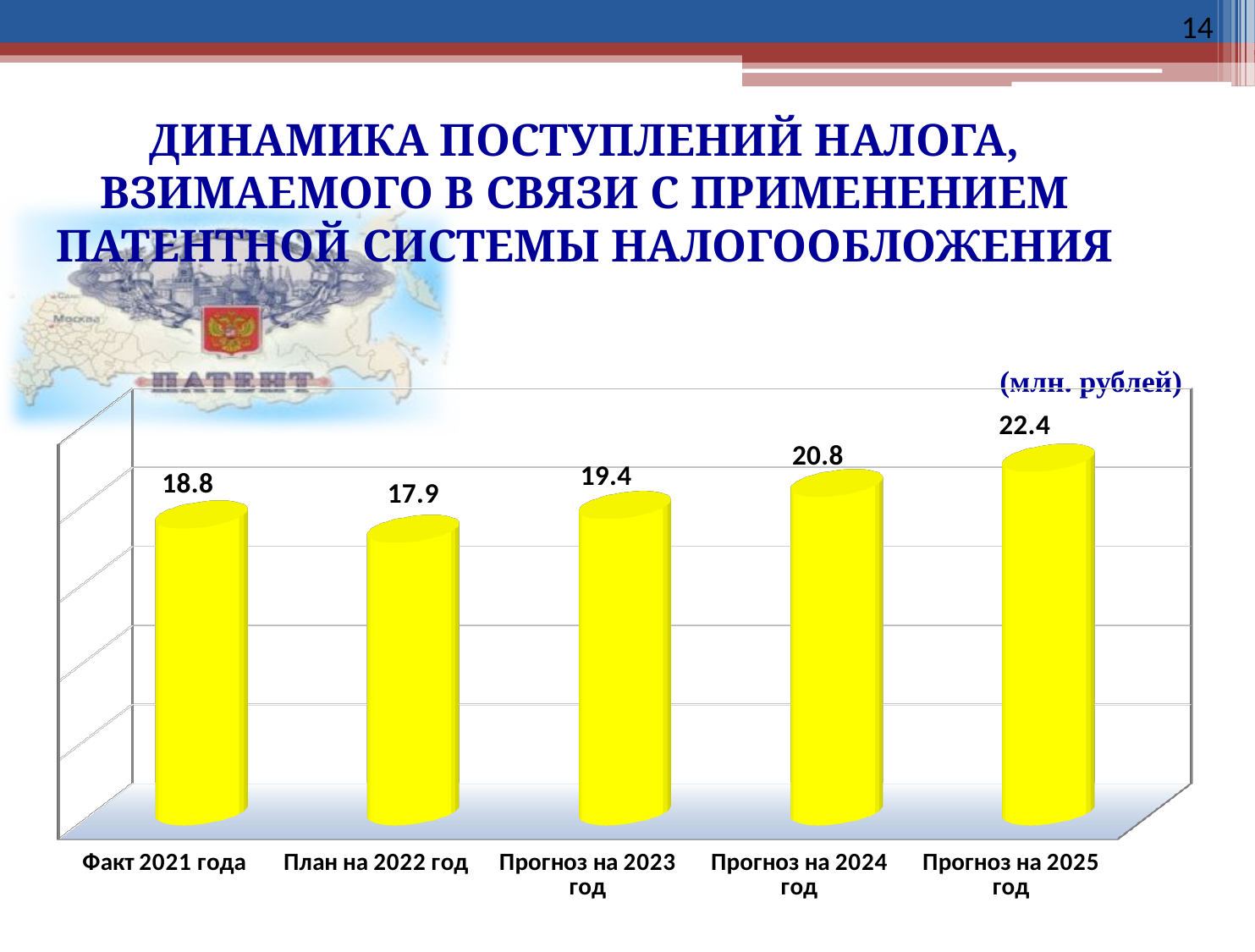
What is the value for План на 2022 год? 17.9 Do the values rise or fall from Прогноз на 2023 год to Прогноз на 2025 год? Rise Which is larger, the value for Факт 2021 года or the value for Прогноз на 2023 год? Прогноз на 2023 год How many categories are shown on the chart? 5 What kind of chart is shown on the slide? Bar chart What is the value for Прогноз на 2024 год? 20.8 What is the value for Факт 2021 года? 18.8 What is the difference between the values for Прогноз на 2023 год and План на 2022 год? 1.5 What is the difference between the values for Прогноз на 2025 год and Факт 2021 года? 3.6 Which category has the lowest value? План на 2022 год In what units are the values on the chart expressed? млн. рублей Which category has the highest value? Прогноз на 2025 год